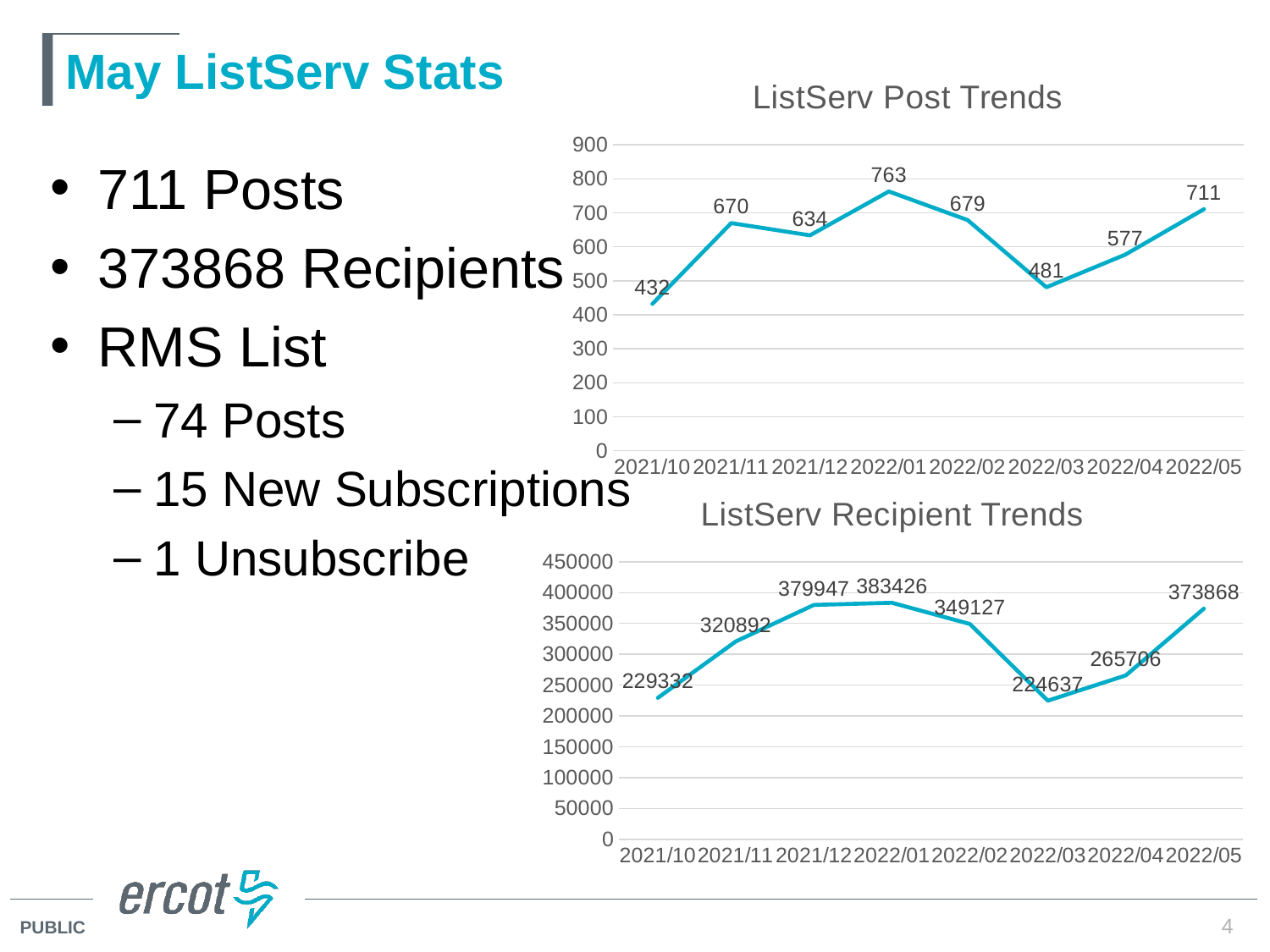
In the ListServ Post Trends chart, which month has the lowest value? 2021/10 What type of chart is the ListServ Post Trends chart? Line chart In the ListServ Post Trends chart, what is the value for 2022/01? 763 In the ListServ Post Trends chart, what is the value for 2021/10? 432 What is the title of the lower chart on the slide? ListServ Recipient Trends In the ListServ Post Trends chart, what is the difference between the values for 2022/05 and 2022/04? 134 In the ListServ Recipient Trends chart, which month has the highest value? 2022/01 In the ListServ Recipient Trends chart, do the values rise or fall from 2022/03 to 2022/05? Rise In the ListServ Post Trends chart, how many data points are plotted? 8 In the ListServ Recipient Trends chart, which is larger, the value for 2021/11 or the value for 2022/04? 2021/11 In the ListServ Recipient Trends chart, what is the difference between the values for 2022/05 and 2022/04? 108162 In the ListServ Recipient Trends chart, what is the value for 2022/03? 224637